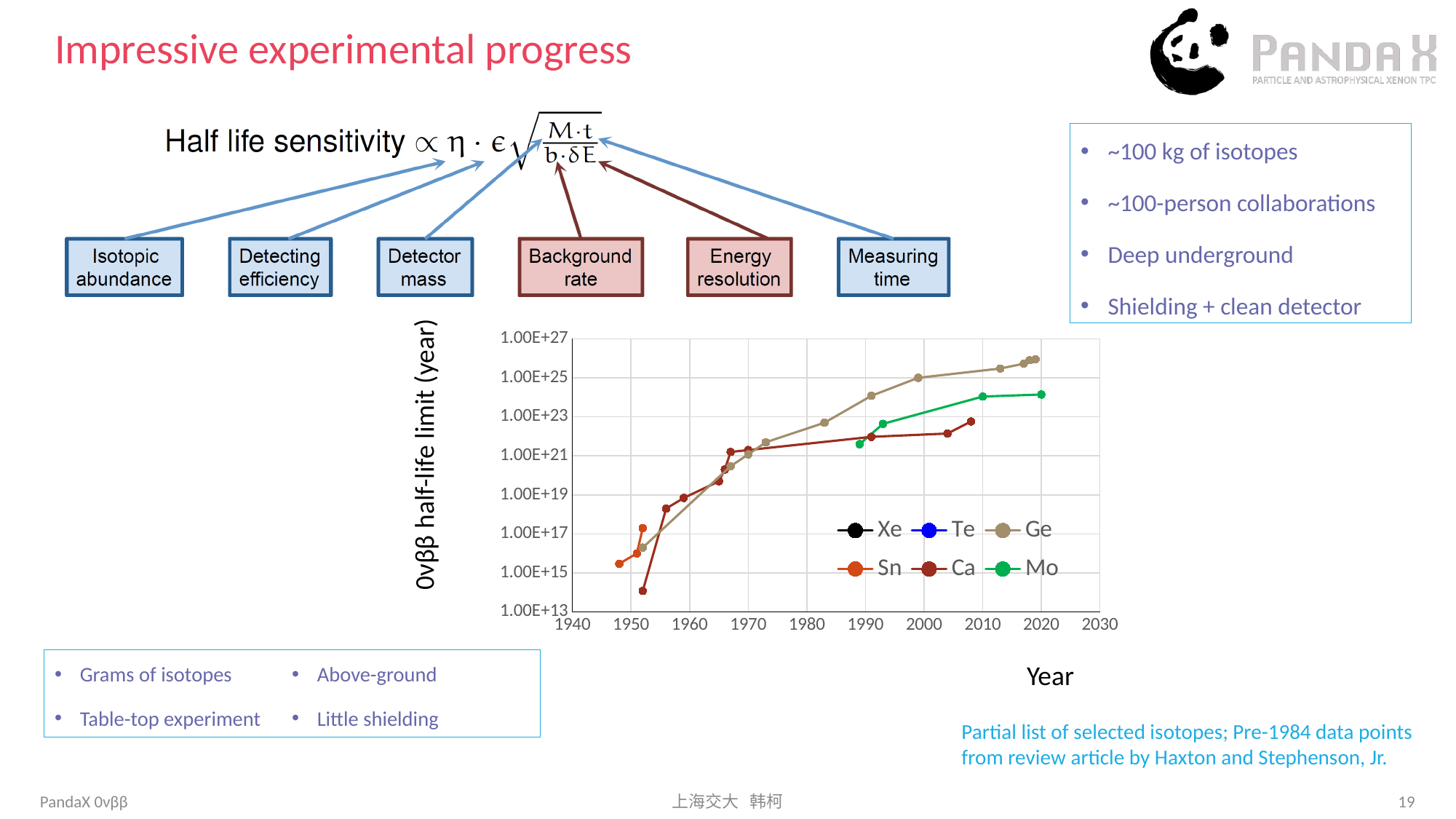
Is the latest Ge value (around 2019) greater or less than 1.00E+25? greater What is the label of the x axis of the chart? Year Is the lowest Ca point (around 1952) greater or less than 1.00E+15? less Does the Ge series rise or fall as the year increases? rise Which series has the lowest plotted point on the chart? Ca What is the label of the y axis of the chart? 0νββ half-life limit (year) How many series does the chart legend list? 6 Around 2020, which series has the larger half-life limit, Ge or Mo? Ge Is the latest Mo value (around 2020) greater or less than 1.00E+23? greater What kind of chart is shown on the slide? line chart What is the highest tick value shown on the y axis of the chart? 1.00E+27 Which series reaches the highest half-life limit on the chart? Ge